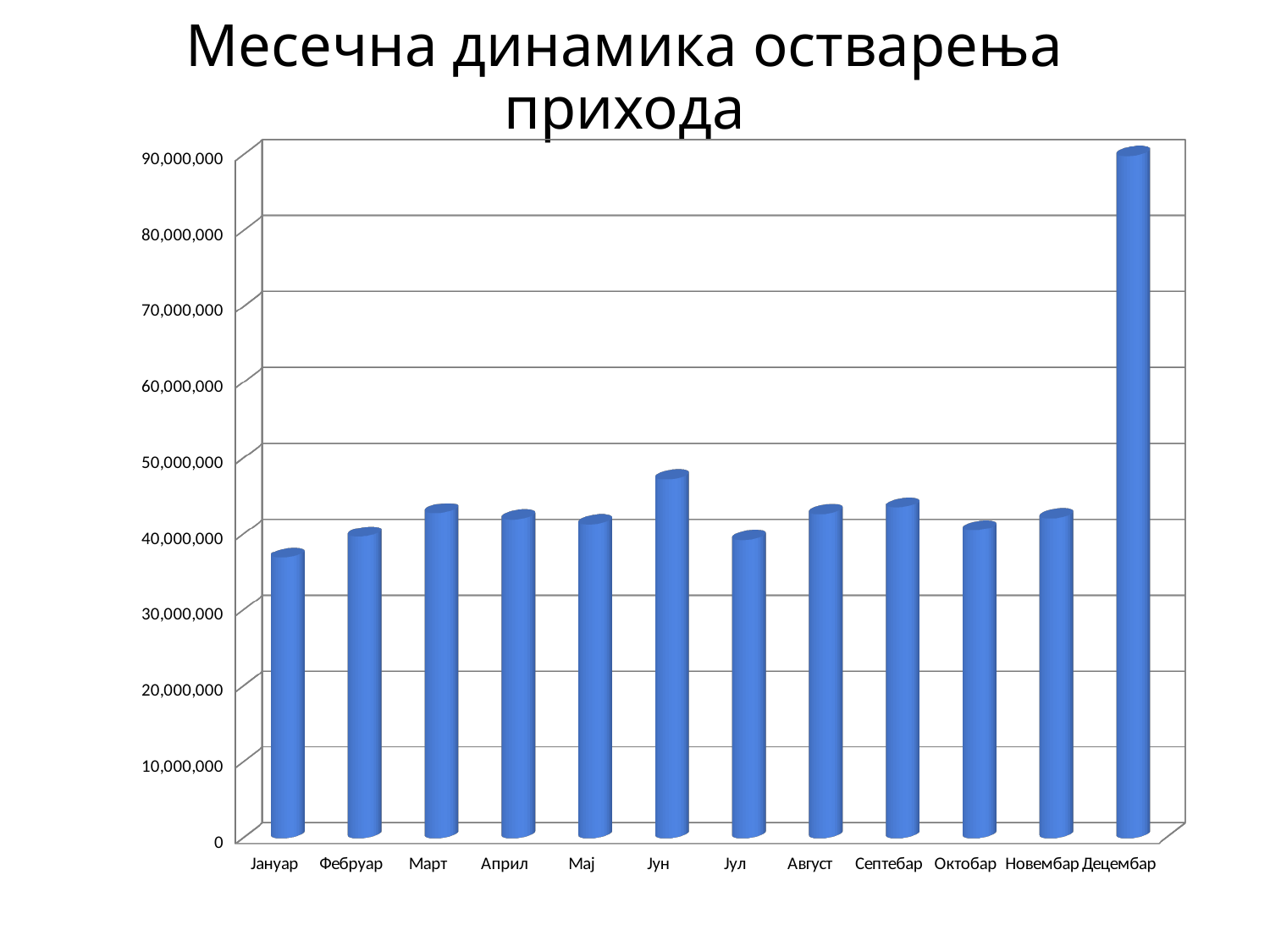
What is the title of the chart on the slide? Месечна динамика остварења прихода Which is larger, the value for Децембар or the value for Јун? Децембар Which month has the highest value in the chart? Децембар Is the value for Јануар greater or less than 40,000,000? less Is the value for Јун greater or less than 50,000,000? less What kind of chart is shown on the slide? Bar chart Is the value for Децембар greater or less than 80,000,000? greater How many months are shown on the x axis of the chart? 12 Which month has the lowest value in the chart? Јануар Which is larger, the value for Јун or the value for Јул? Јун